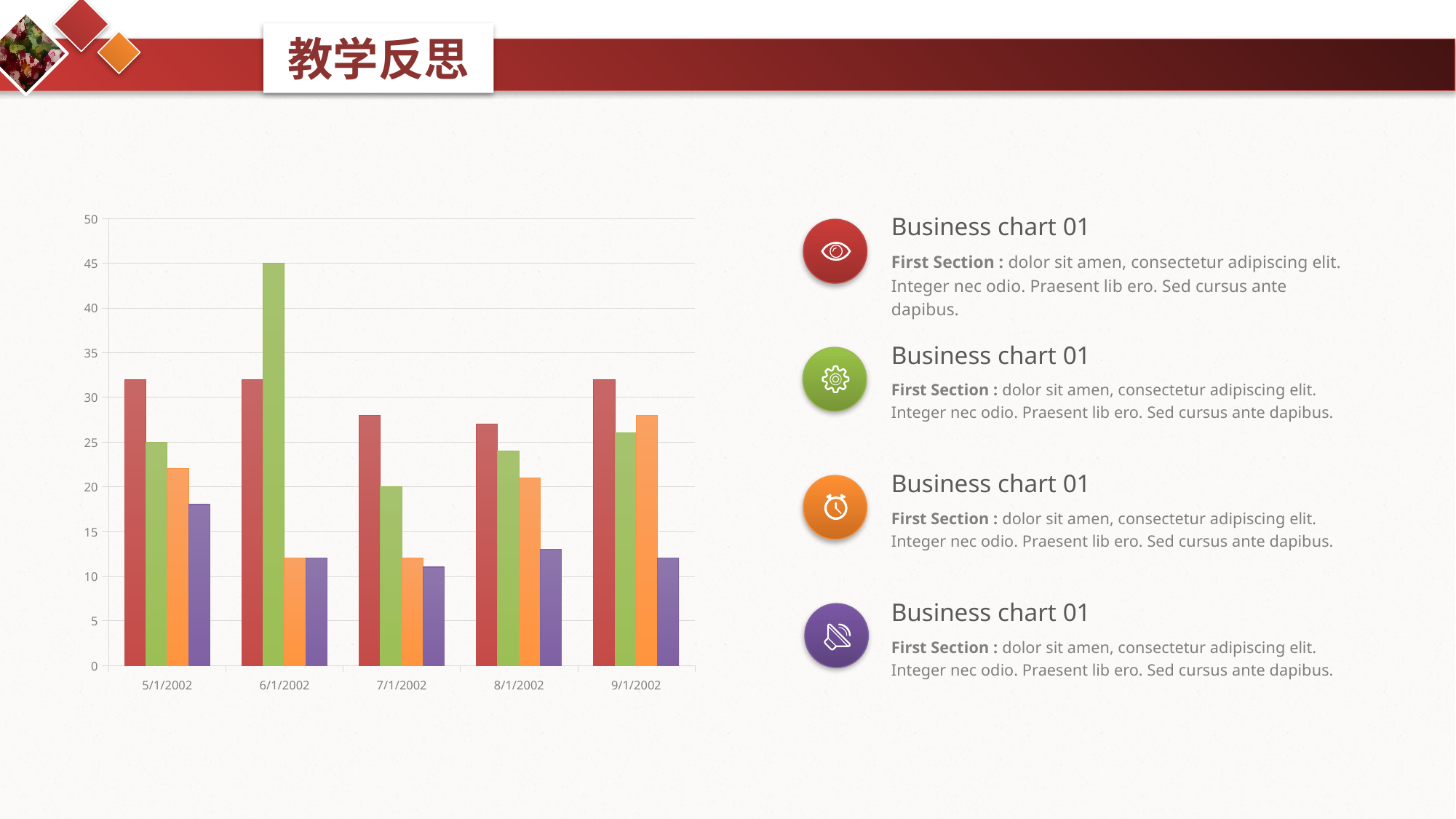
What colour is the tallest bar in the chart? green Which date category contains the tallest bar in the chart? 6/1/2002 Do the purple bars rise or fall from 5/1/2002 to 7/1/2002? fall How many bars are plotted for each date category in the chart? 4 What kind of chart is shown on the slide? bar chart For 5/1/2002, which is larger: the red bar or the purple bar? the red bar Is the value of the red bar for 5/1/2002 greater or less than 30? greater Is the value of the orange bar for 9/1/2002 greater or less than 25? greater What is the value of the green bar for 5/1/2002? 25 What is the value of the green bar for 6/1/2002? 45 How many date categories are shown on the x axis of the chart? 5 Is the value of the purple bar for 7/1/2002 greater or less than 15? less